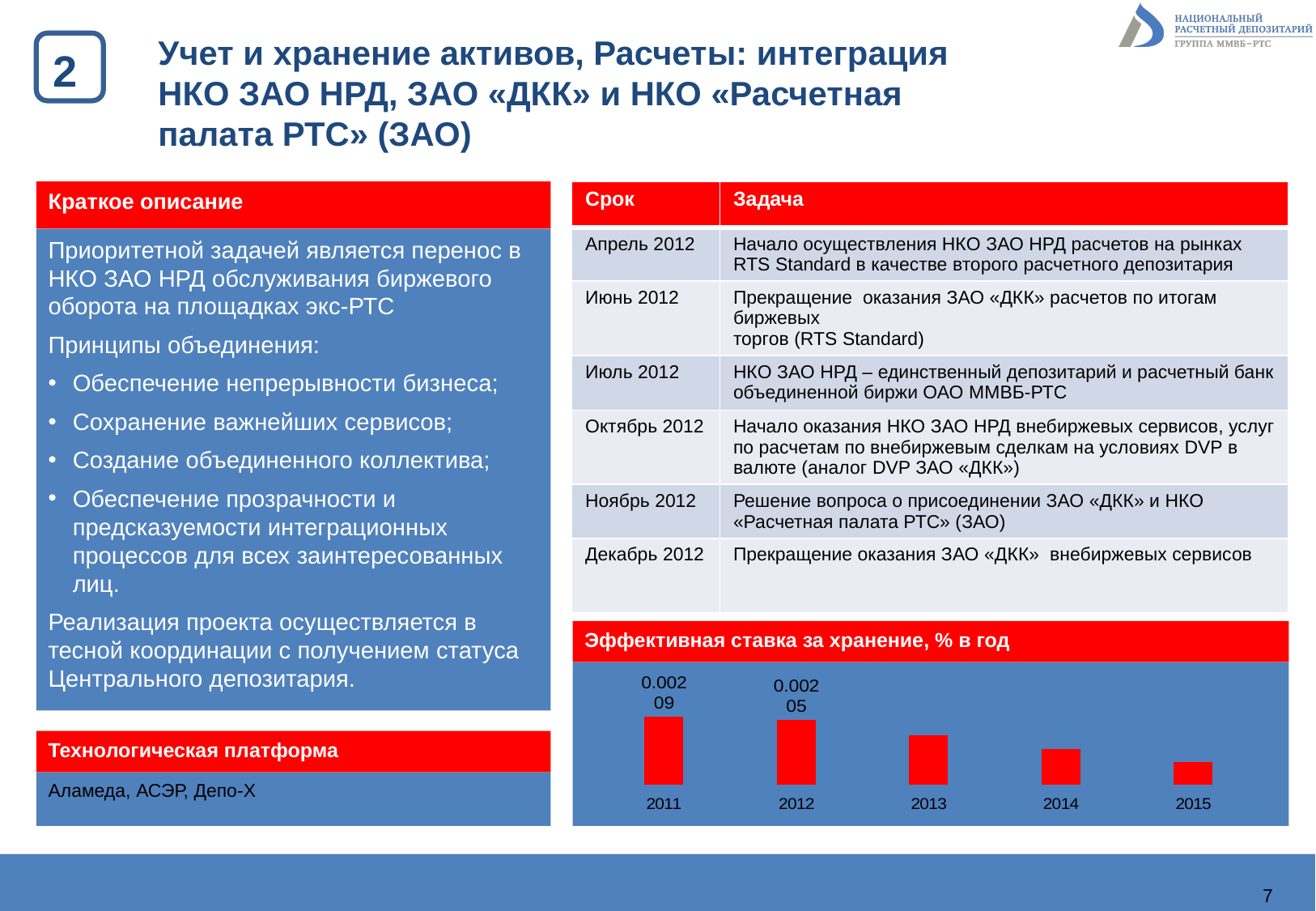
What kind of chart is 'Эффективная ставка за хранение, % в год'? Bar chart What colour are the bars in the chart 'Эффективная ставка за хранение, % в год'? Red What is the value for 2011 in the chart 'Эффективная ставка за хранение, % в год'? 0.00209 Do the values in the chart 'Эффективная ставка за хранение, % в год' rise or fall from 2011 to 2015? Fall What is the difference between the values for 2011 and 2012 in the chart 'Эффективная ставка за хранение, % в год'? 0.00004 In the chart 'Эффективная ставка за хранение, % в год', which is larger, the value for 2013 or the value for 2015? 2013 Which year has the highest value in the chart 'Эффективная ставка за хранение, % в год'? 2011 How many years are shown in the chart 'Эффективная ставка за хранение, % в год'? 5 What is the title of the chart at the bottom right of the slide? Эффективная ставка за хранение, % в год What is the value for 2012 in the chart 'Эффективная ставка за хранение, % в год'? 0.00205 Which year has the lowest value in the chart 'Эффективная ставка за хранение, % в год'? 2015 In the chart 'Эффективная ставка за хранение, % в год', which is larger, the value for 2012 or the value for 2014? 2012